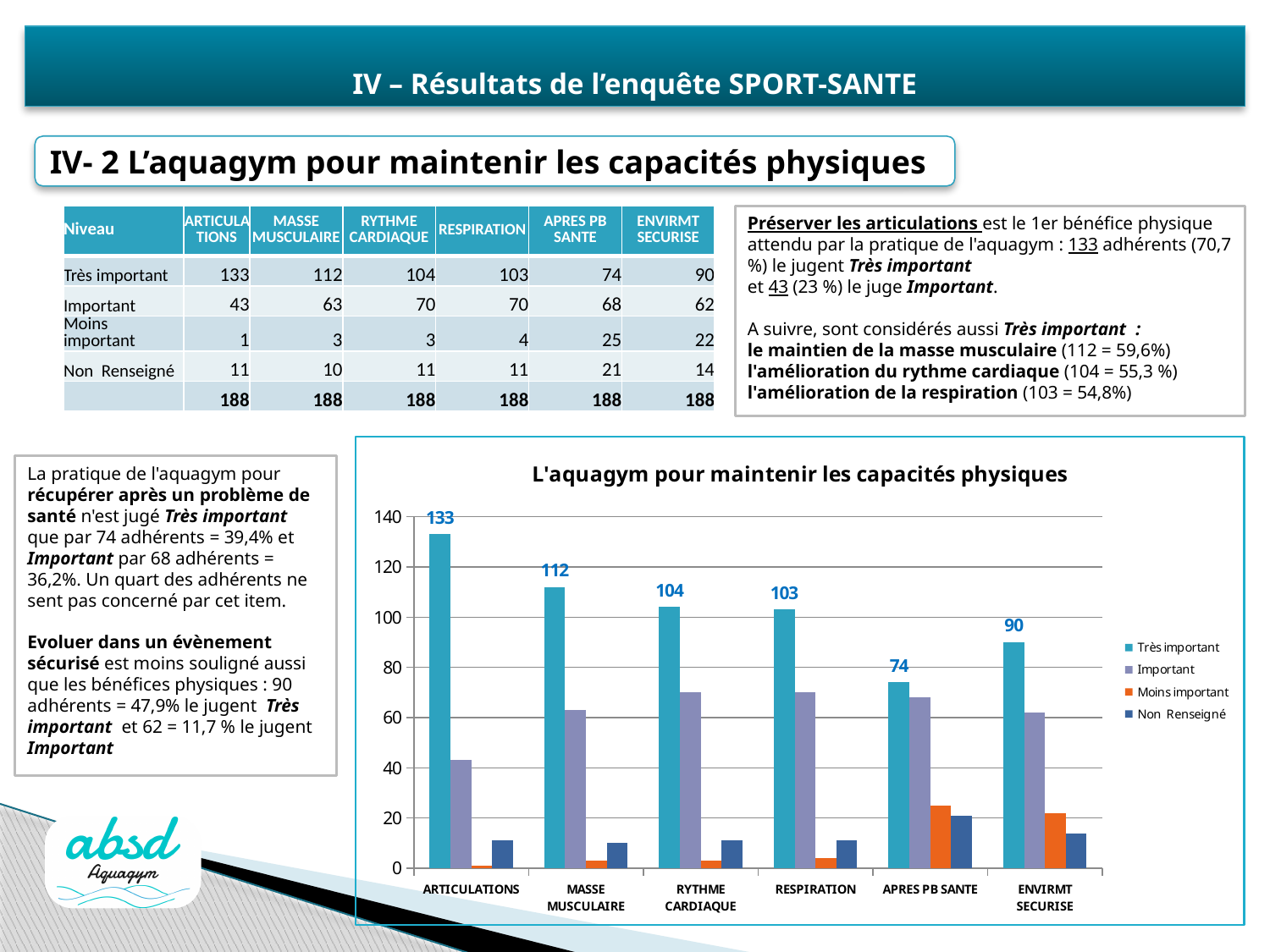
Which is larger, the Très important value for RYTHME CARDIAQUE or for RESPIRATION? RYTHME CARDIAQUE What kind of chart is shown? bar chart How many series does the legend list? 4 What is the value for Très important for ARTICULATIONS? 133 Is the Important value for ARTICULATIONS greater or less than 60? less What is the difference between the Très important values for ARTICULATIONS and MASSE MUSCULAIRE? 21 What is the value for Très important for ENVIRMT SECURISE? 90 Is the Moins important value for APRES PB SANTE greater or less than 20? greater What is the value for Très important for APRES PB SANTE? 74 Which category has the highest Très important value? ARTICULATIONS Which category has the lowest Très important value? APRES PB SANTE How many categories are shown on the x axis? 6